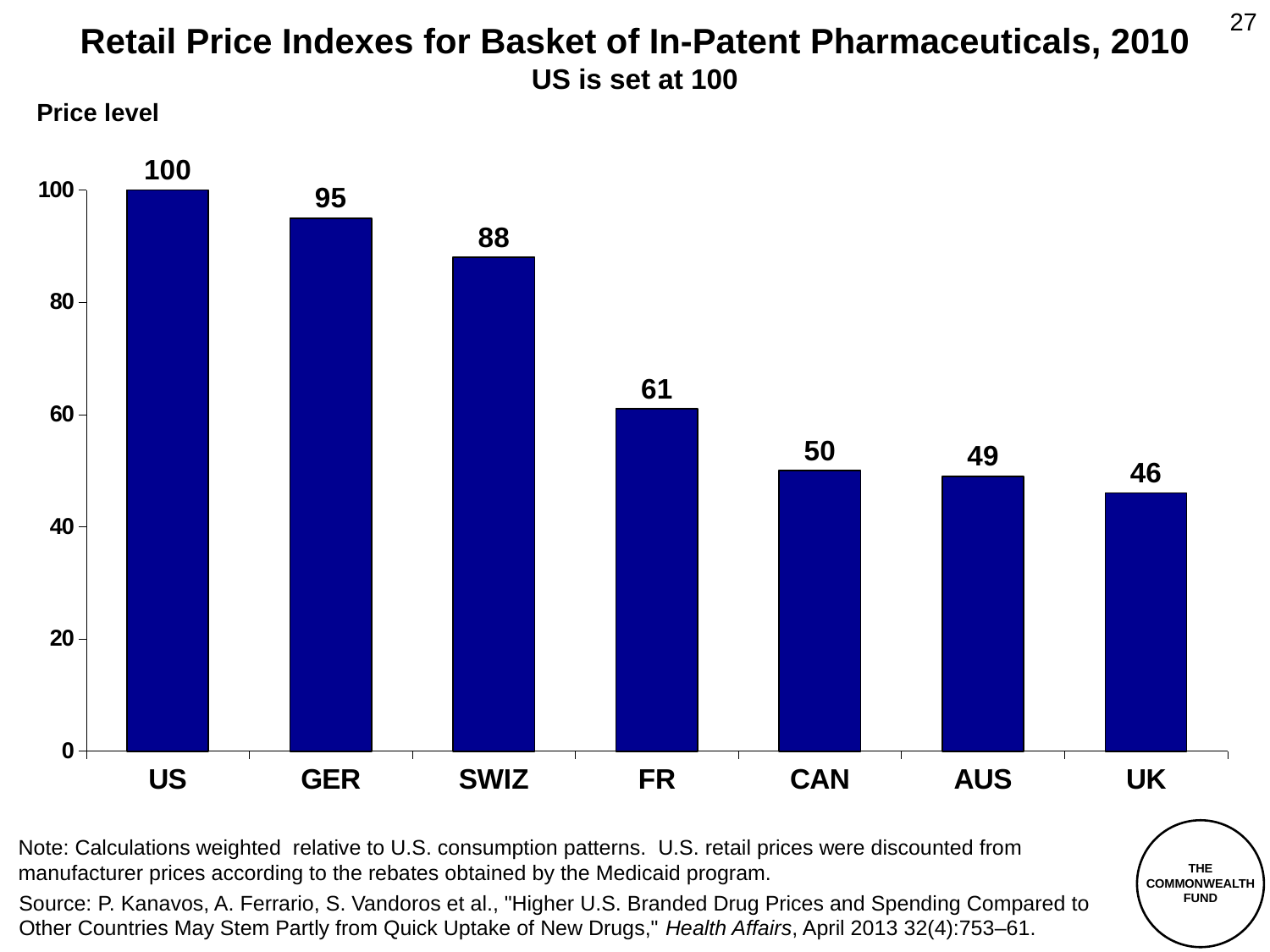
What is the difference between the price levels for GER and UK? 49 What is the difference between the price levels for US and FR? 39 What is the title of the chart? Retail Price Indexes for Basket of In-Patent Pharmaceuticals, 2010 Which country has the highest price level? US What is the price level for CAN? 50 Do the price levels rise or fall from left to right across the countries? Fall How many countries are shown in the chart? 7 What is the price level for SWIZ? 88 Which has a higher price level, SWIZ or FR? SWIZ Which country has the lowest price level? UK What is the price level for GER? 95 What kind of chart is shown on the slide? Bar chart